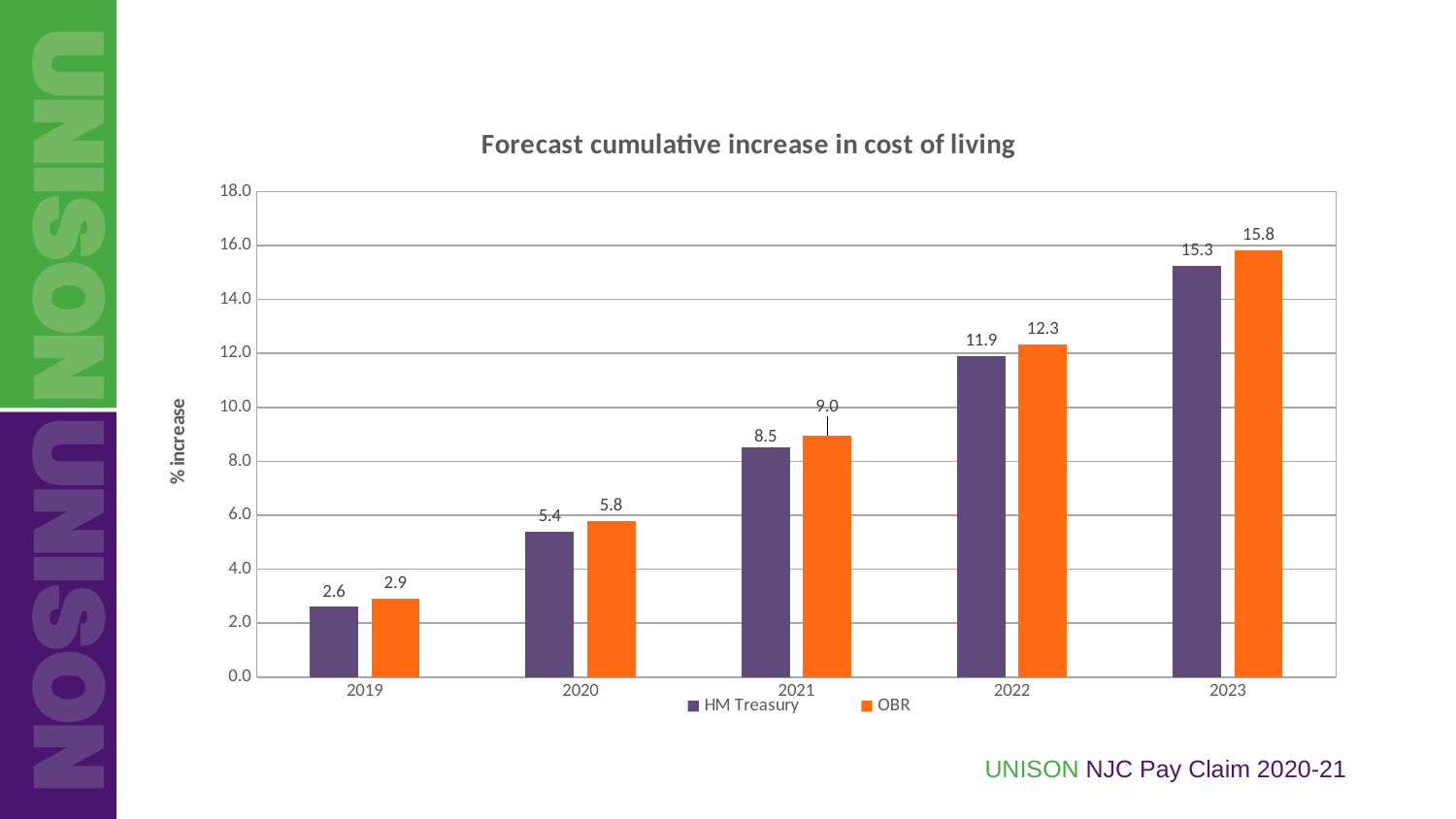
What is the HM Treasury forecast cumulative increase in cost of living for 2021? 8.5 What is the OBR value for 2019? 2.9 What is the difference between the OBR and HM Treasury forecasts for 2022? 0.4 How many series does the legend list? 2 What kind of chart is shown on the slide? Bar chart Which is larger for 2020, the HM Treasury forecast or the OBR forecast? OBR Do the OBR forecast values rise or fall from 2019 to 2023? Rise How many years are shown on the x axis? 5 Which year has the lowest OBR forecast? 2019 Is the HM Treasury value for 2022 greater or less than 10.0? greater Which year has the highest HM Treasury forecast? 2023 What is the OBR forecast cumulative increase in cost of living for 2023? 15.8